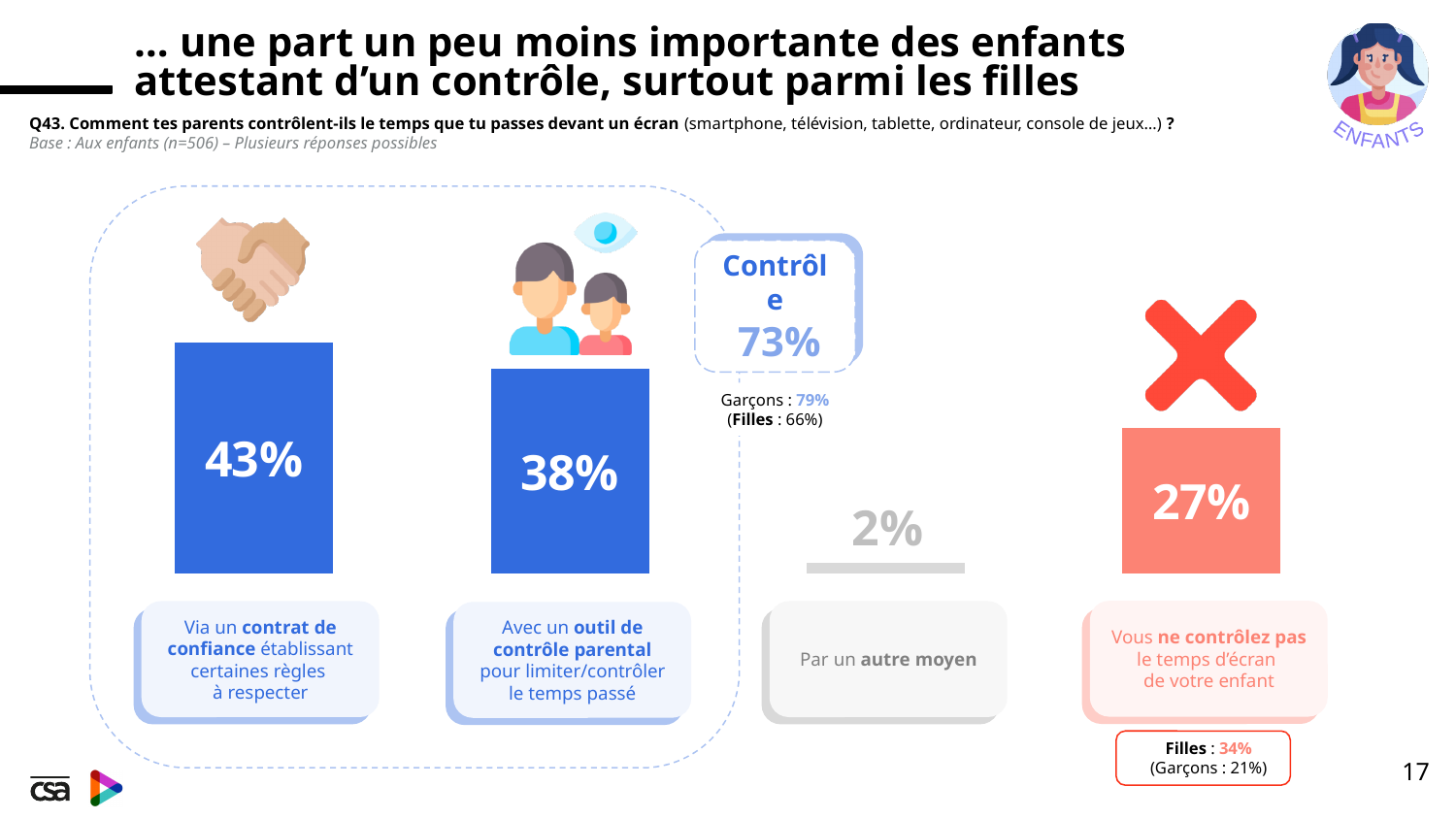
What is the difference in percentage points between 'contrat de confiance' and 'outil de contrôle parental'? 5 points Which response category has the highest percentage? Via un contrat de confiance What percentage of boys (Garçons) report some form of control, according to the callout? 79% How many response categories are shown as bars on the slide? 4 What percentage of children say their parents control screen time via a 'contrat de confiance'? 43% What is the overall 'Contrôle' percentage shown in the callout? 73% What percentage of children say their parents do not control their screen time ('ne contrôlez pas')? 27% Which is larger: the share for 'outil de contrôle parental' or the share for 'ne contrôlez pas'? Outil de contrôle parental Which response category has the lowest percentage? Par un autre moyen What percentage of children say their parents use an 'outil de contrôle parental'? 38% What percentage of children answered 'Par un autre moyen'? 2% What percentage of girls (Filles) say their parents do not control their screen time? 34%